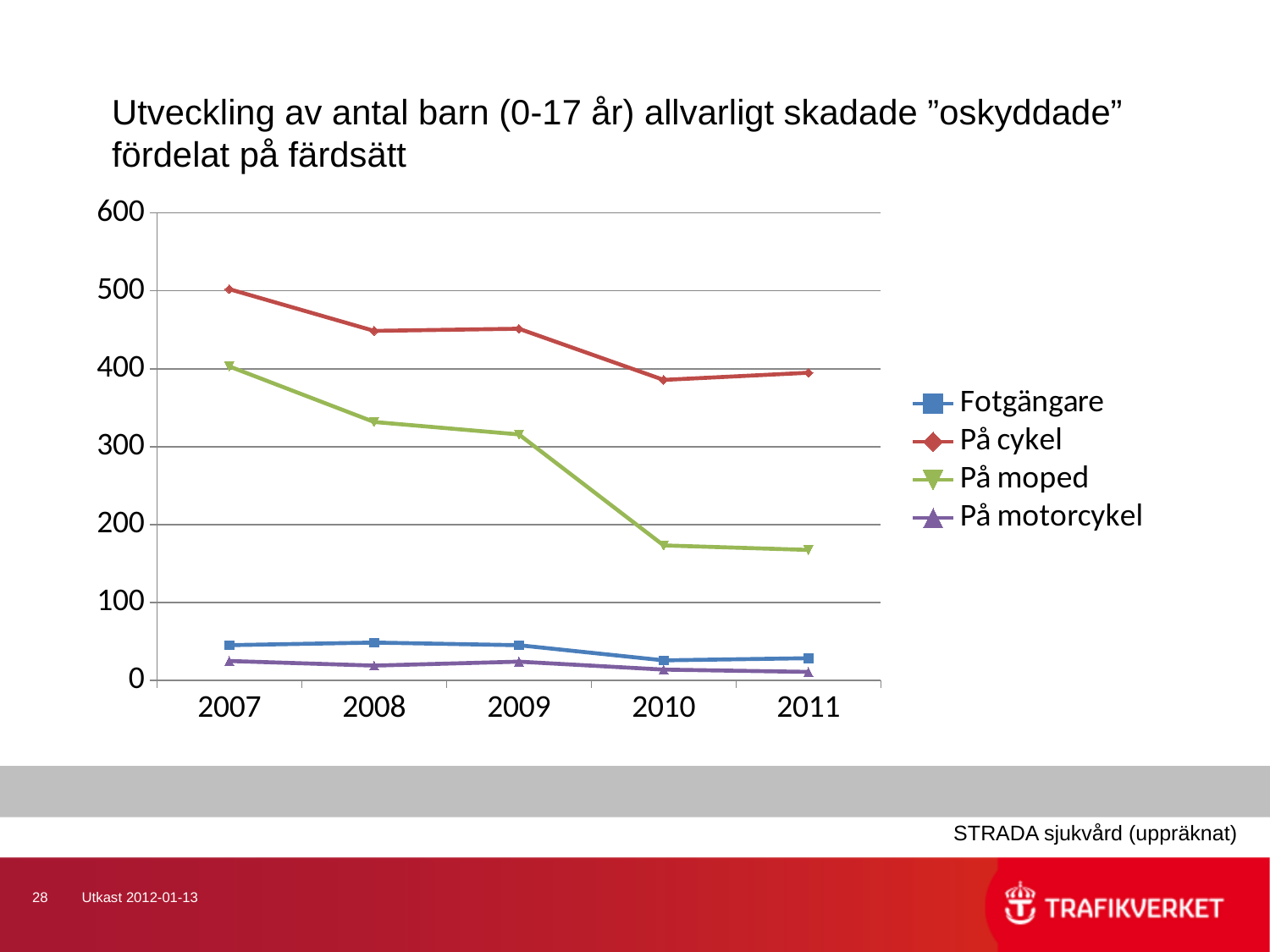
How many series does the legend list? 4 Is the value for På cykel in 2007 greater or less than 400? greater What is the first year shown on the x axis? 2007 Is the value for På moped in 2008 greater or less than 300? greater Is the value for På moped in 2010 greater or less than 200? less Does the På moped series rise or fall from 2007 to 2011? fall Which is larger in 2011, the value for På cykel or the value for På moped? På cykel Which series has the lowest value in 2011? På motorcykel Which series has the highest value in 2007? På cykel How many years are shown on the x axis? 5 What kind of chart is shown on the slide? line chart